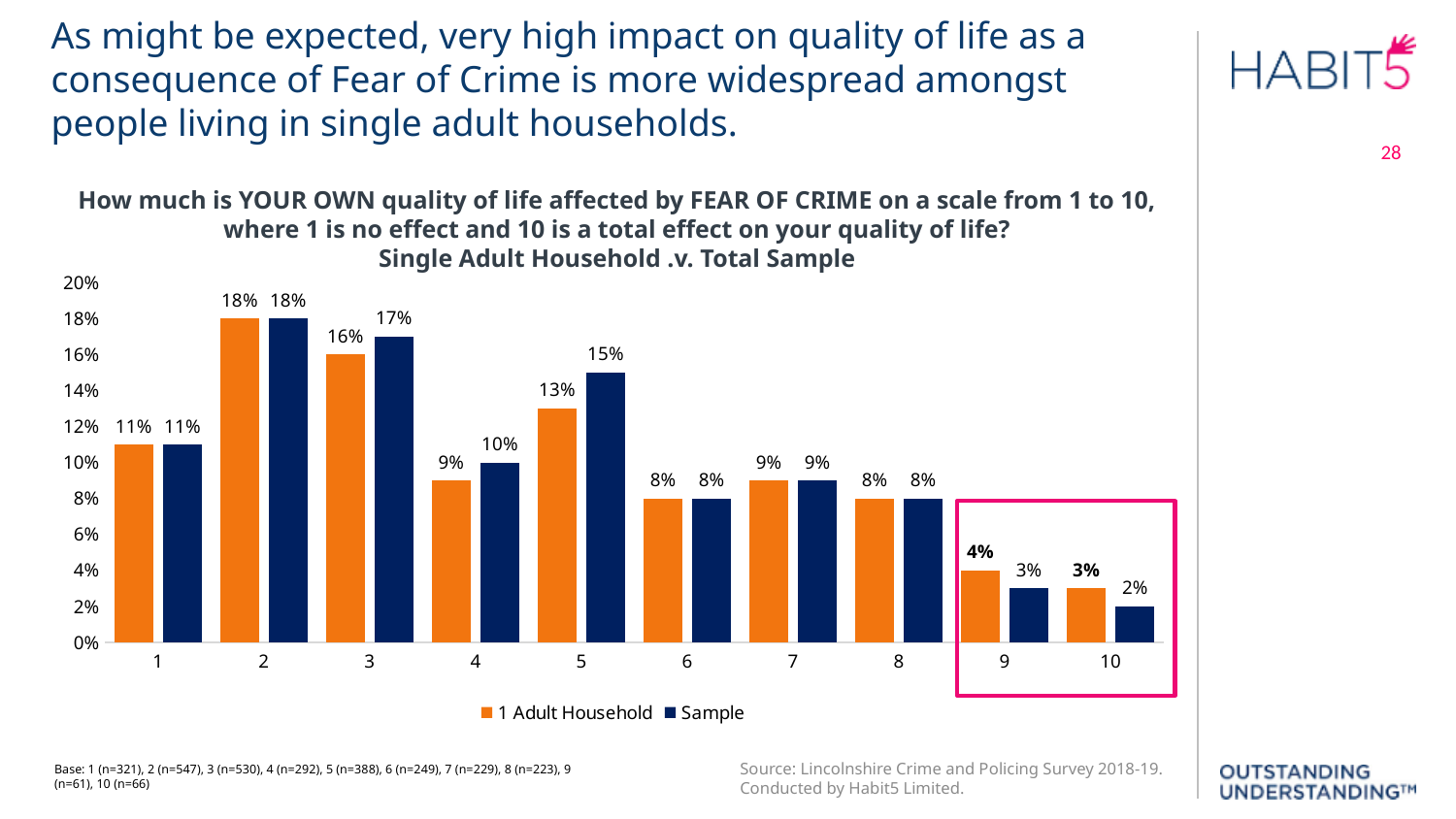
Which scale point has the lowest value for the 1 Adult Household series? 10 What is the value for Sample at scale point 3? 17% What kind of chart is shown on the slide? Bar chart What is the value for 1 Adult Household at scale point 9? 4% At scale point 10, which series has the larger value, 1 Adult Household or Sample? 1 Adult Household How many series does the legend list? 2 Which scale point has the highest value for the Sample series? 2 How many scale points are shown on the x axis? 10 Is the value for Sample at scale point 4 greater or less than 8%? greater What is the value for 1 Adult Household at scale point 5? 13% Which scale points are highlighted by the pink box on the chart? 9 and 10 What is the difference between the Sample and 1 Adult Household values at scale point 5? 2%